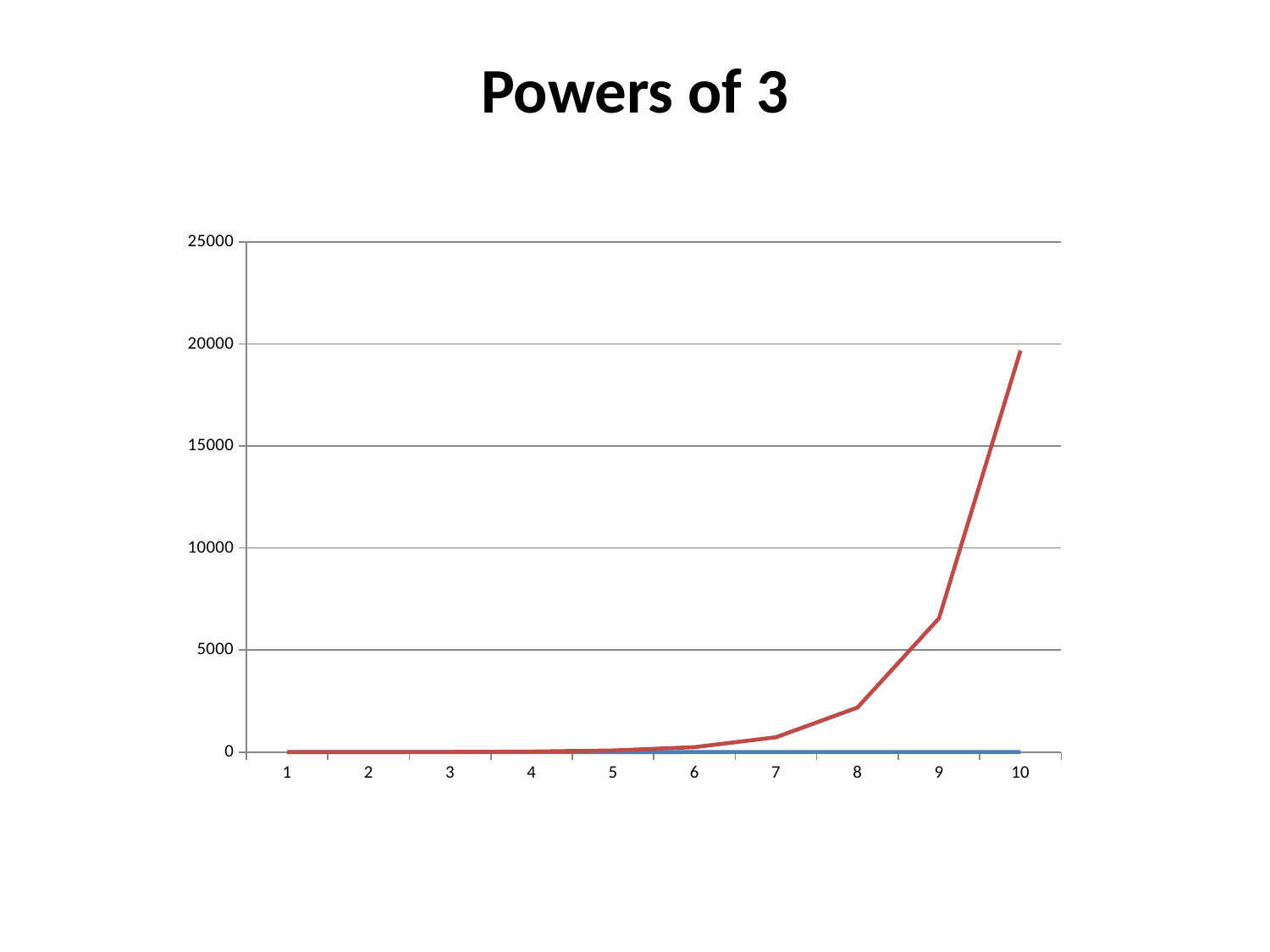
Is the value of the red line at x = 8 greater or less than 5000? less What is the title of the chart? Powers of 3 Is the value of the red line at x = 9 greater or less than 5000? greater How many lines are plotted on the chart? 2 Is the value of the red line at x = 10 greater or less than 15000? greater What kind of chart is shown on the slide? line chart How many points are marked along the x axis of the chart? 10 At which x-axis value does the red line reach its highest point? 10 Does the red line rise or fall as the x axis goes from 1 to 10? rise At x = 10, which line has the larger value, the red line or the blue line? red line